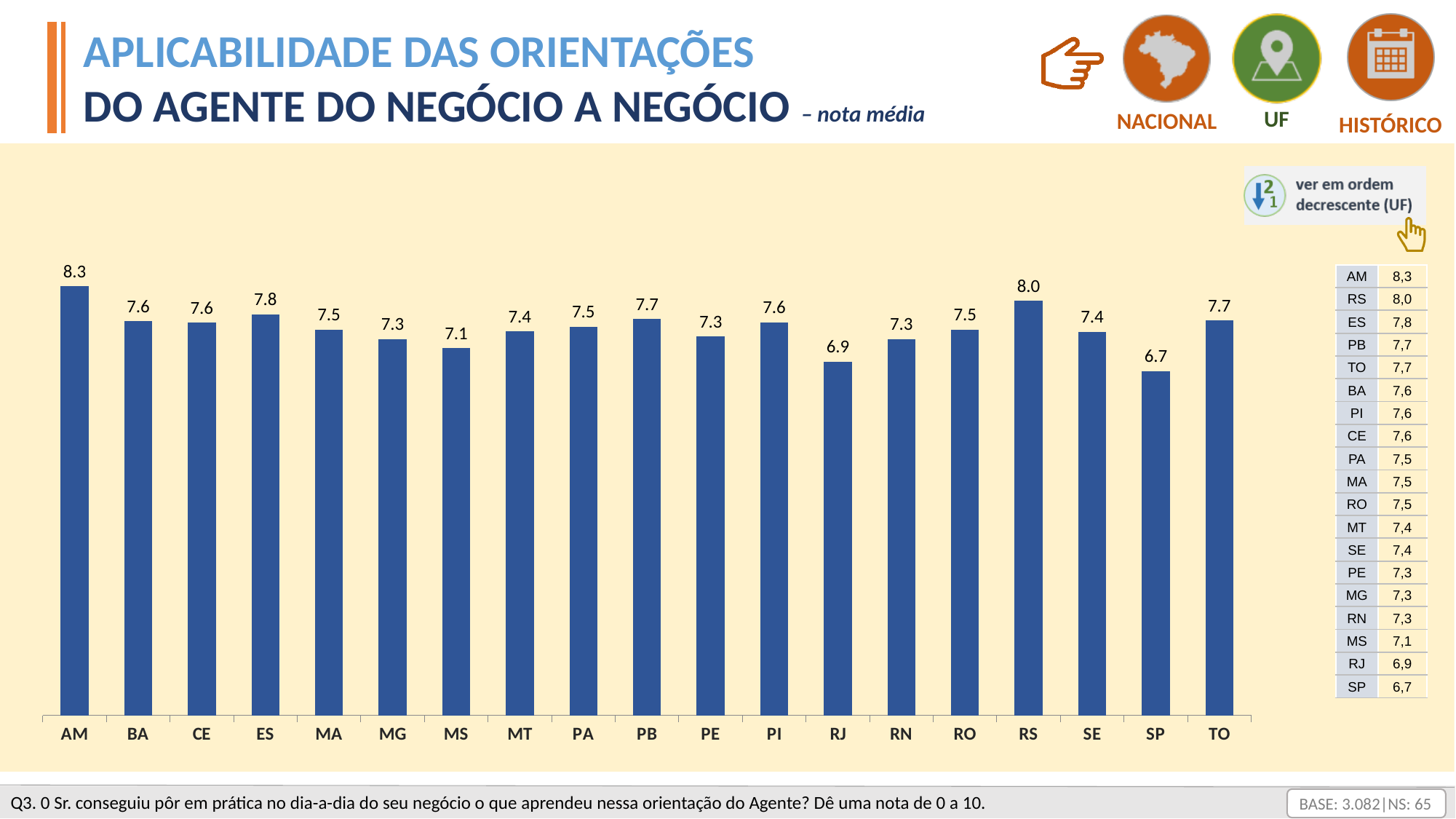
Which state has the lowest value? SP What is the difference between the values for AM and SP? 1.6 What is the value for SP? 6.7 Which is larger, the value for ES or the value for MS? ES What is the value for RJ? 6.9 What kind of chart is shown? bar chart What is the value for RS? 8.0 How many states are shown on the x axis? 19 What is the value for PB? 7.7 What is the difference between the values for RS and RJ? 1.1 Which state has the highest value? AM What is the value for AM? 8.3